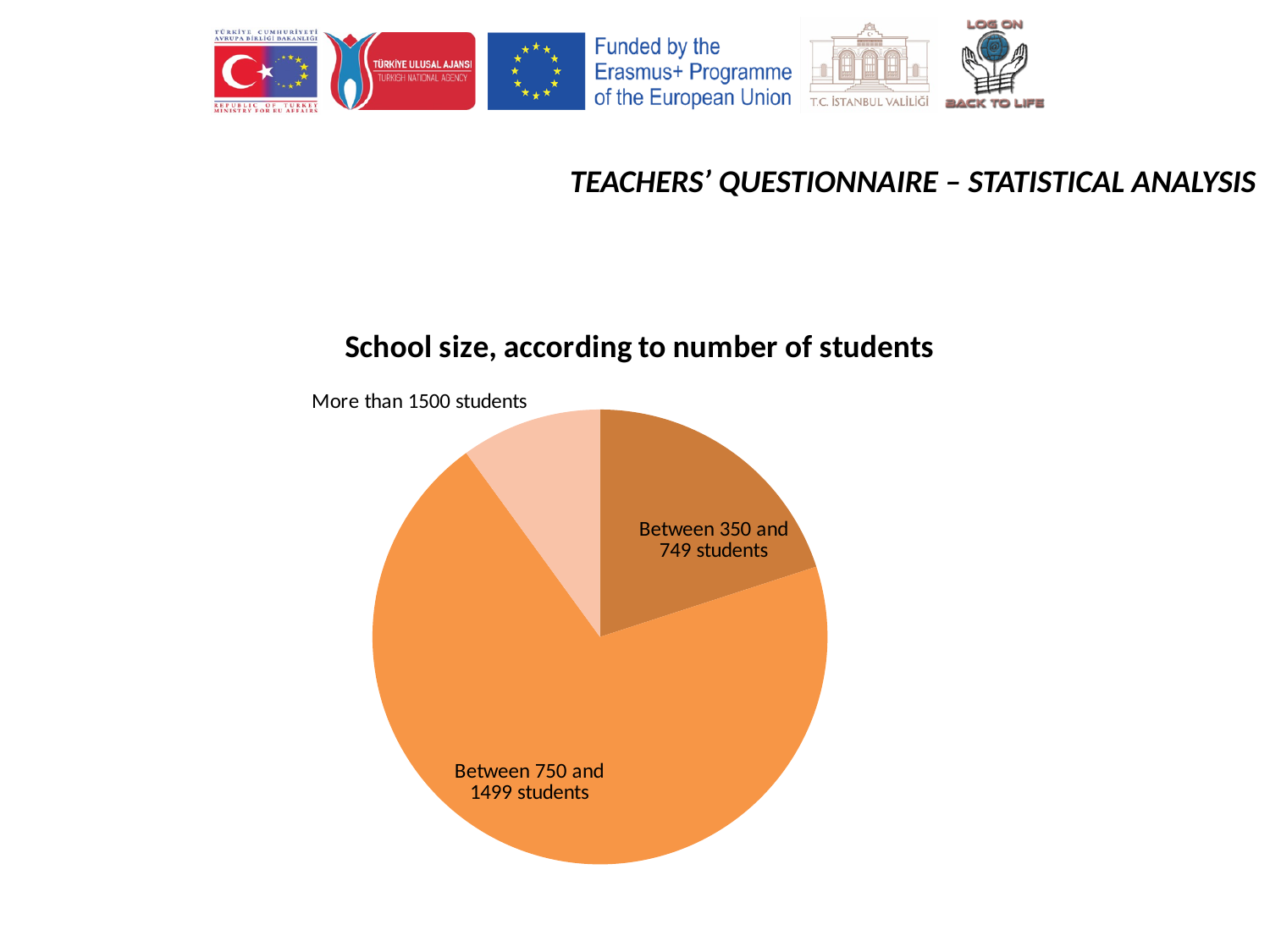
What is the title of the chart? School size, according to number of students Does the "Between 750 and 1499 students" slice take up more or less than half of the pie? More Which category has the largest slice of the pie? Between 750 and 1499 students Which category is shown in the lightest colour on the pie chart? More than 1500 students Which slice is larger: "Between 750 and 1499 students" or "Between 350 and 749 students"? Between 750 and 1499 students Which category has the smallest slice of the pie? More than 1500 students Which slice is larger: "Between 350 and 749 students" or "More than 1500 students"? Between 350 and 749 students What kind of chart is shown on the slide? Pie chart How many slices does the pie chart have? 3